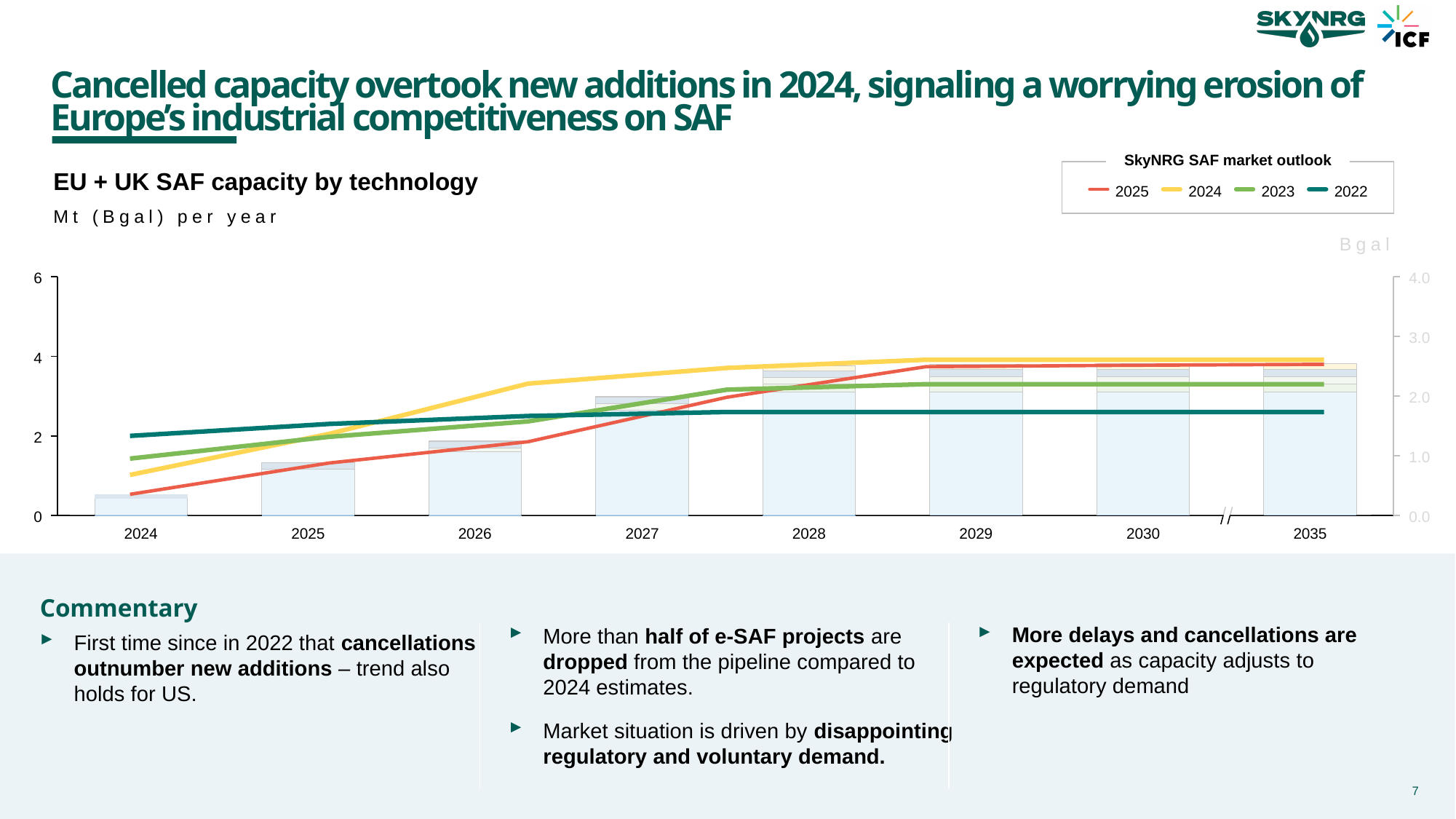
Which series are listed in the SkyNRG SAF market outlook legend? 2025, 2024, 2023, 2022 Is the capacity bar for 2025 greater or less than 2 on the left axis? less What kind of chart is shown on the slide? A combined bar and line chart Which market outlook series is the lowest at 2024? 2025 Is the capacity bar for 2029 greater or less than 2 on the left axis? greater Which is larger, the capacity bar for 2028 or the capacity bar for 2024? 2028 Which market outlook series is the highest at 2024? 2022 How many years are shown on the x axis of the chart? 8 Does the 2025 market outlook line rise or fall from 2024 to 2029? rise How many series does the SkyNRG SAF market outlook legend list? 4 Is the capacity bar for 2024 greater or less than 2 on the left axis? less Which market outlook series is the lowest at 2035? 2022